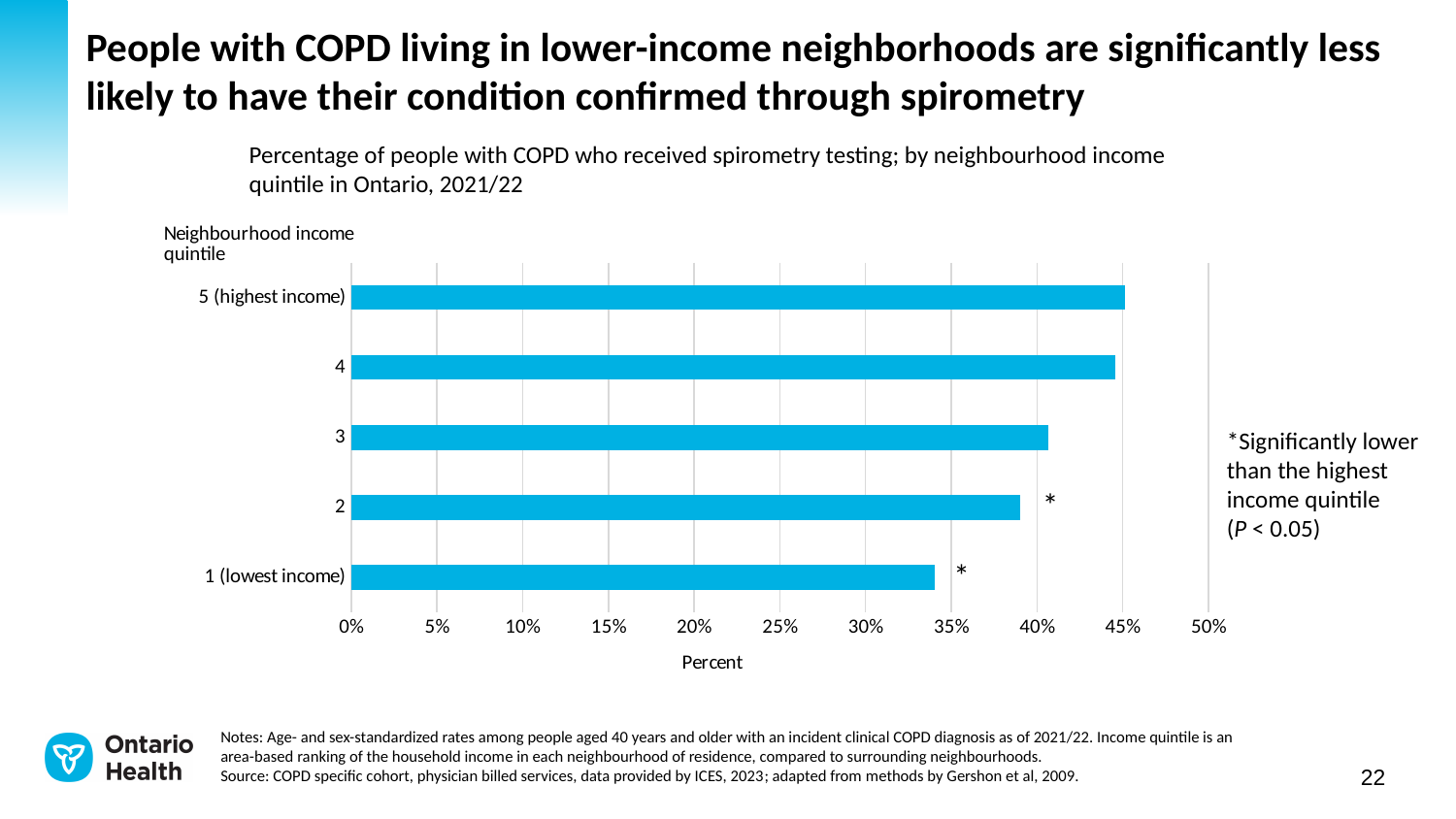
Is the value for quintile 1 (lowest income) greater or less than 40%? less Is the value for quintile 2 greater or less than 35%? greater What kind of chart is shown on the slide? bar chart Do the percentages rise or fall as the neighbourhood income quintile goes from 5 (highest income) down to 1 (lowest income)? fall Which has a higher percentage of spirometry testing: quintile 4 or quintile 3? 4 How many neighbourhood income quintile categories are plotted in the chart? 5 Which has a higher percentage of spirometry testing: quintile 3 or quintile 1 (lowest income)? 3 Is the value for quintile 4 greater or less than 40%? greater Which neighbourhood income quintile has the lowest percentage of people with COPD who received spirometry testing? 1 (lowest income) Which quintiles are marked with an asterisk as significantly lower than the highest income quintile? 2 and 1 (lowest income)